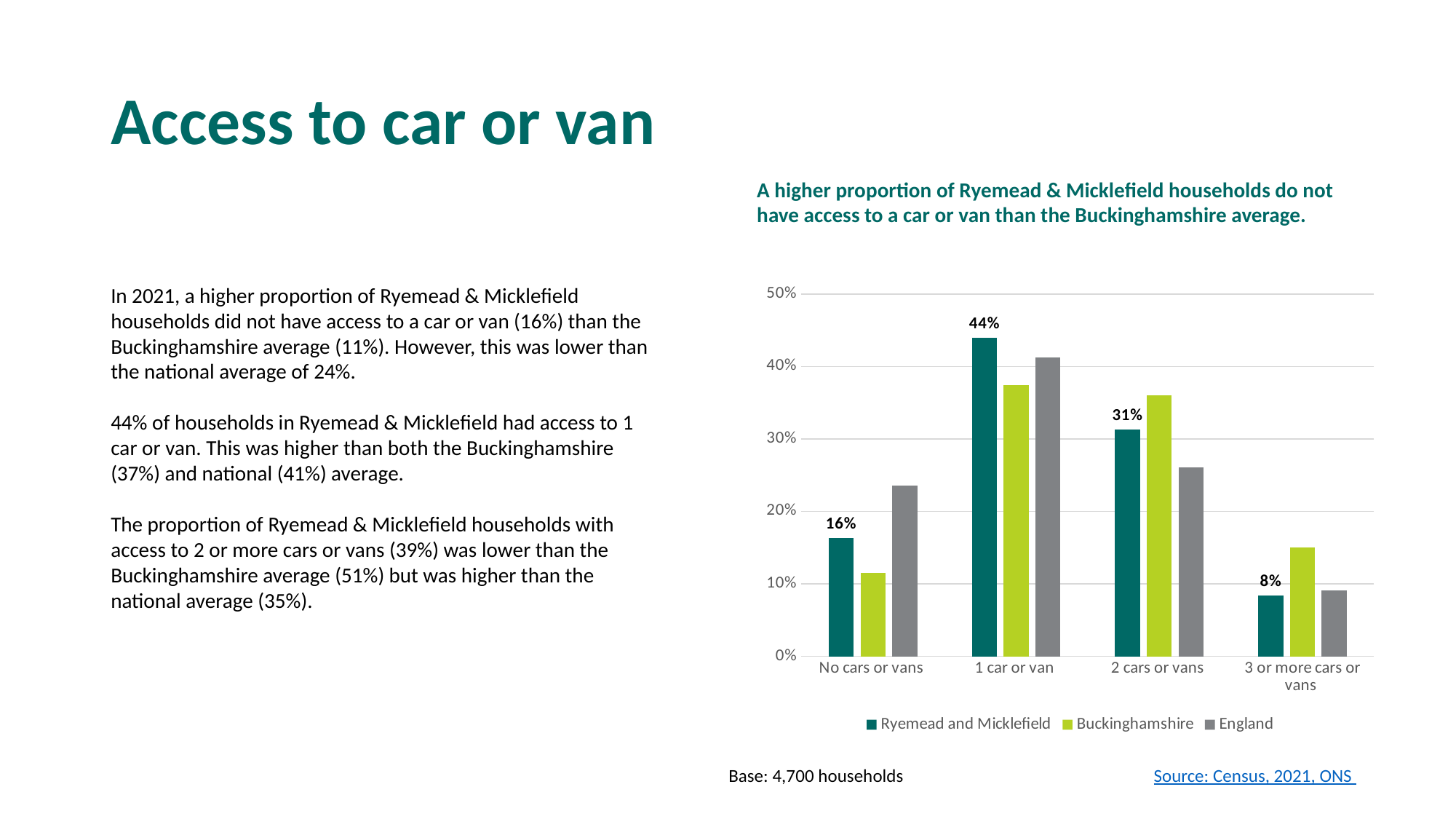
How many categories are shown on the x axis? 4 What is the value for Ryemead and Micklefield in the '1 car or van' category? 44% What is the value for Ryemead and Micklefield in the '3 or more cars or vans' category? 8% What type of chart is shown on the slide? Bar chart In the 'No cars or vans' category, which series has the larger value: Ryemead and Micklefield or Buckinghamshire? Ryemead and Micklefield What is the value for Ryemead and Micklefield in the 'No cars or vans' category? 16% What is the difference between the Ryemead and Micklefield values for '1 car or van' and '2 cars or vans'? 13% How many series does the legend list? 3 Which series is shown in grey in the legend? England Which category has the lowest value for Ryemead and Micklefield? 3 or more cars or vans Is the value for England in the 'No cars or vans' category greater or less than 20%? greater Which category has the highest value for Ryemead and Micklefield? 1 car or van